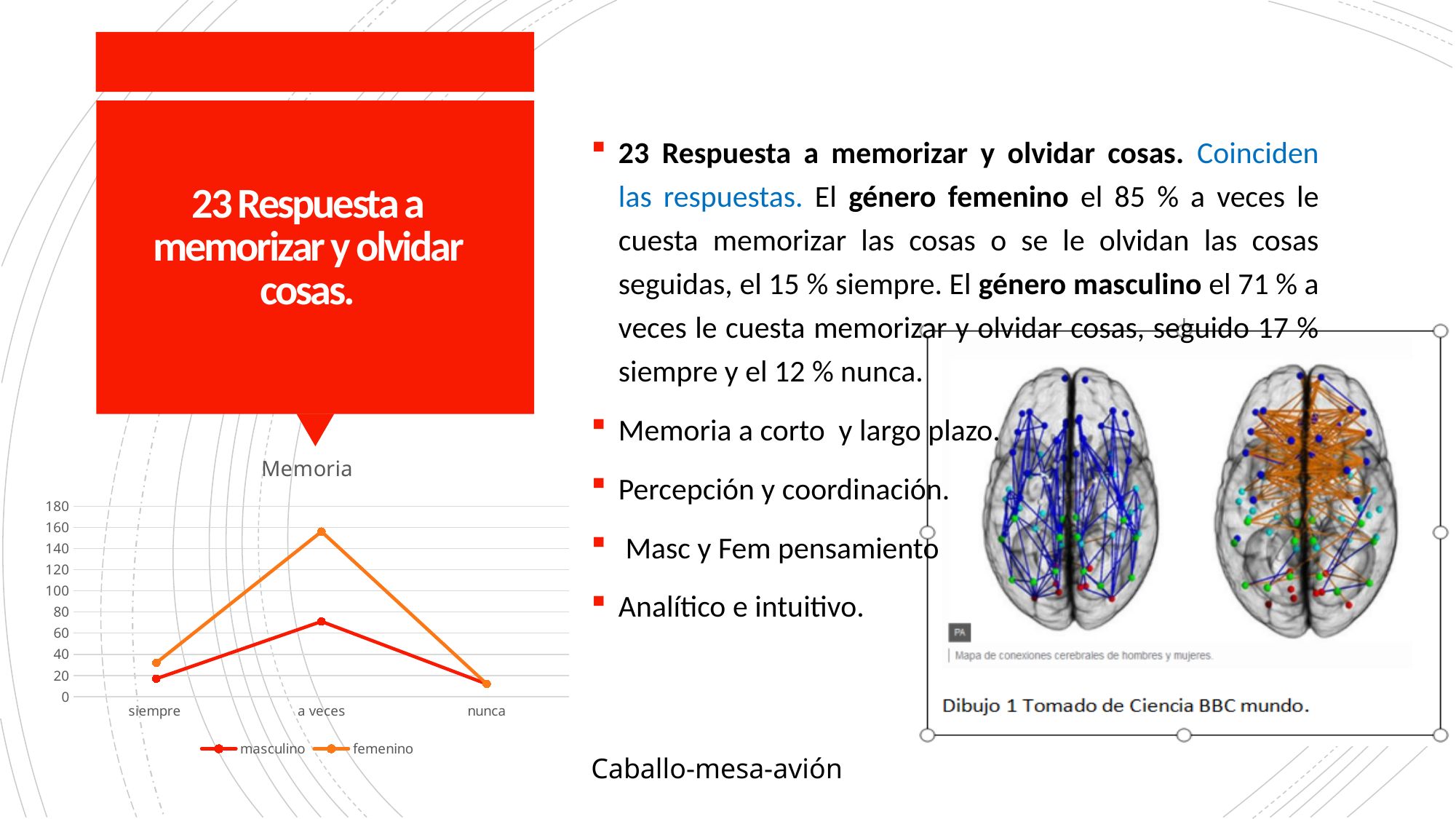
In the Memoria chart, which series has the larger value for "a veces", masculino or femenino? femenino In the Memoria chart, is the masculino value for "a veces" greater or less than 80? less What colour is the femenino line in the Memoria chart? orange In the Memoria chart, does the masculino series rise or fall from "a veces" to "nunca"? fall Which category has the highest value for the femenino series in the Memoria chart? a veces Which category has the highest value for the masculino series in the Memoria chart? a veces How many categories are shown on the x axis of the Memoria chart? 3 How many series does the legend of the Memoria chart list? 2 In the Memoria chart, is the masculino value for "siempre" greater or less than 40? less What kind of chart is shown under the title "Memoria"? line chart